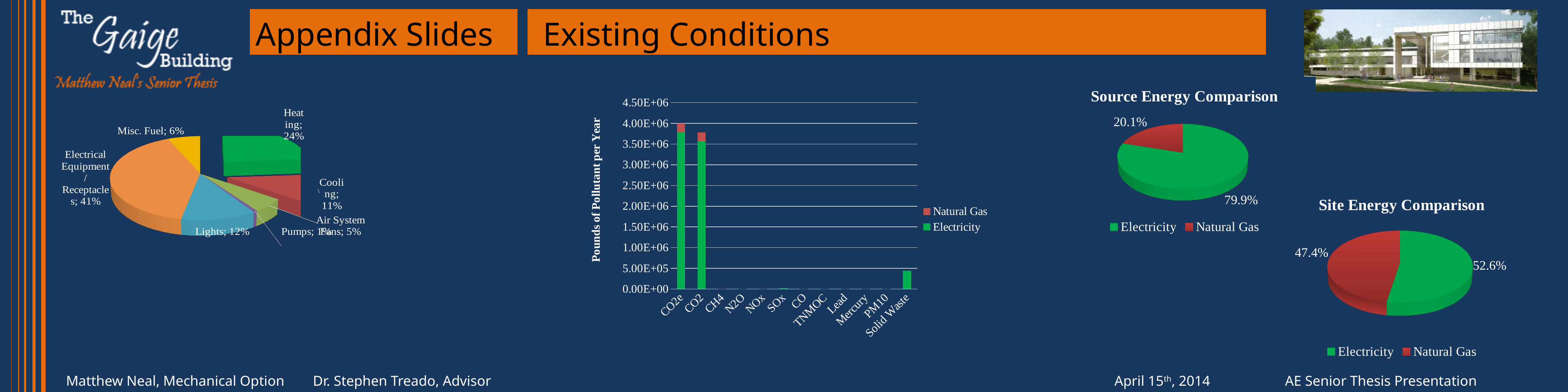
In the Site Energy Comparison pie chart, what share is Natural Gas? 47.4% In the pie chart on the left of the slide, what share is Heating? 24% In the bar chart of Pounds of Pollutant per Year, is the total value for Solid Waste greater or less than 1.00E+06? less In the Site Energy Comparison pie chart, which slice is larger, Electricity or Natural Gas? Electricity In the Source Energy Comparison pie chart, what share is Natural Gas? 20.1% In the pie chart on the left of the slide, what is the difference between the Cooling and Air System Fans shares? 6% In the bar chart of Pounds of Pollutant per Year, how many categories are shown on the x axis? 12 In the Source Energy Comparison pie chart, what share is Electricity? 79.9% In the Site Energy Comparison pie chart, what is the difference between the Electricity and Natural Gas shares? 5.2% In the bar chart of Pounds of Pollutant per Year, how many series does the legend list? 2 In the pie chart on the left of the slide, which category has the largest share? Electrical Equipment / Receptacles In the pie chart on the left of the slide, what share is Lights? 12%